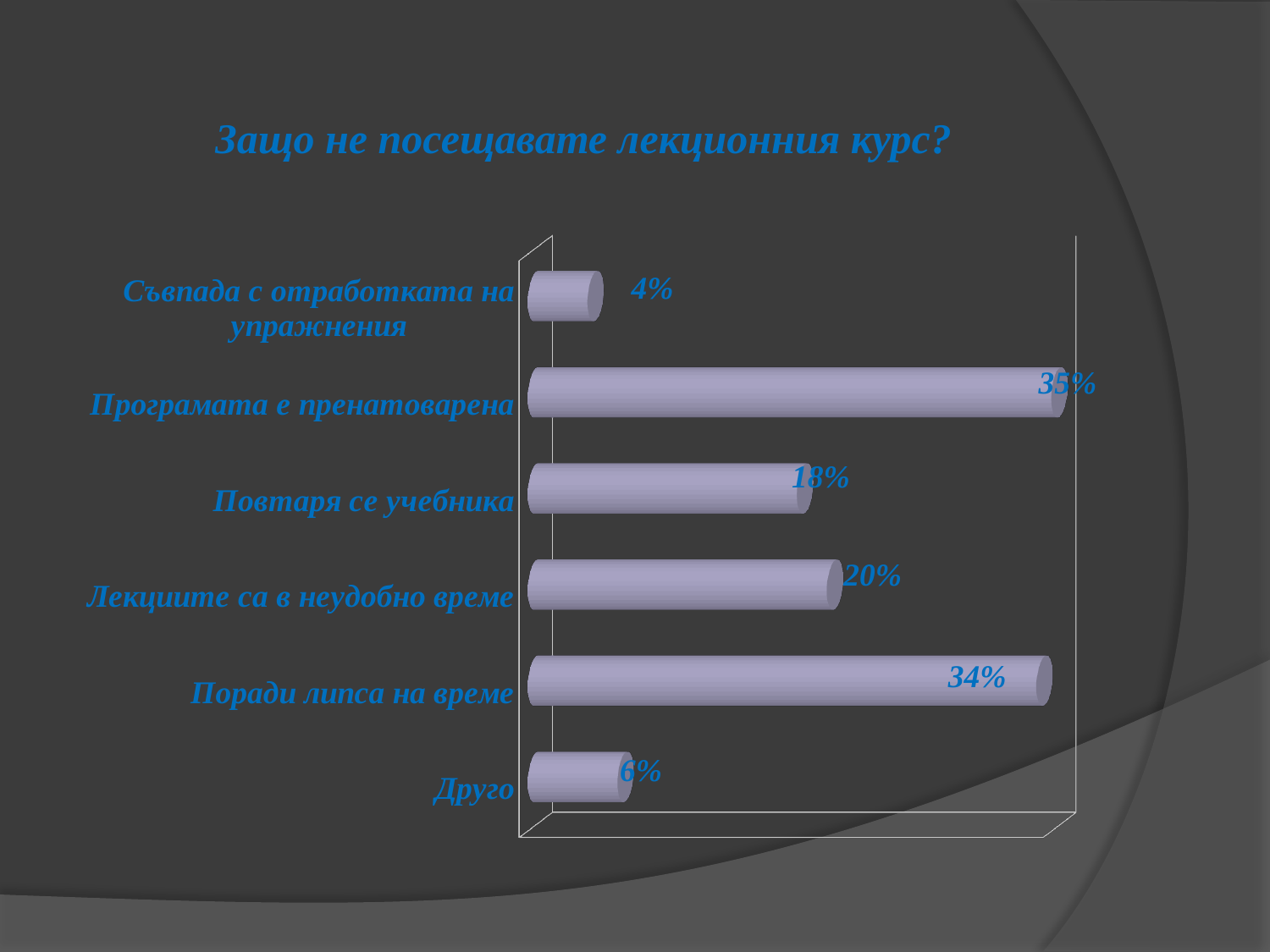
Which is larger, the value for "Повтаря се учебника" or the value for "Лекциите са в неудобно време"? Лекциите са в неудобно време What is the difference between the values for "Програмата е пренатоварена" and "Поради липса на време"? 1% What is the value for "Съвпада с отработката на упражнения"? 4% Which category has the highest value? Програмата е пренатоварена What is the value for "Поради липса на време"? 34% What is the difference between the values for "Лекциите са в неудобно време" and "Повтаря се учебника"? 2% What kind of chart is shown on the slide? Bar chart Which category has the lowest value? Съвпада с отработката на упражнения How many categories are shown in the chart? 6 What is the value for "Програмата е пренатоварена"? 35% What is the title of the chart? Защо не посещавате лекционния курс? What is the value for "Друго"? 6%